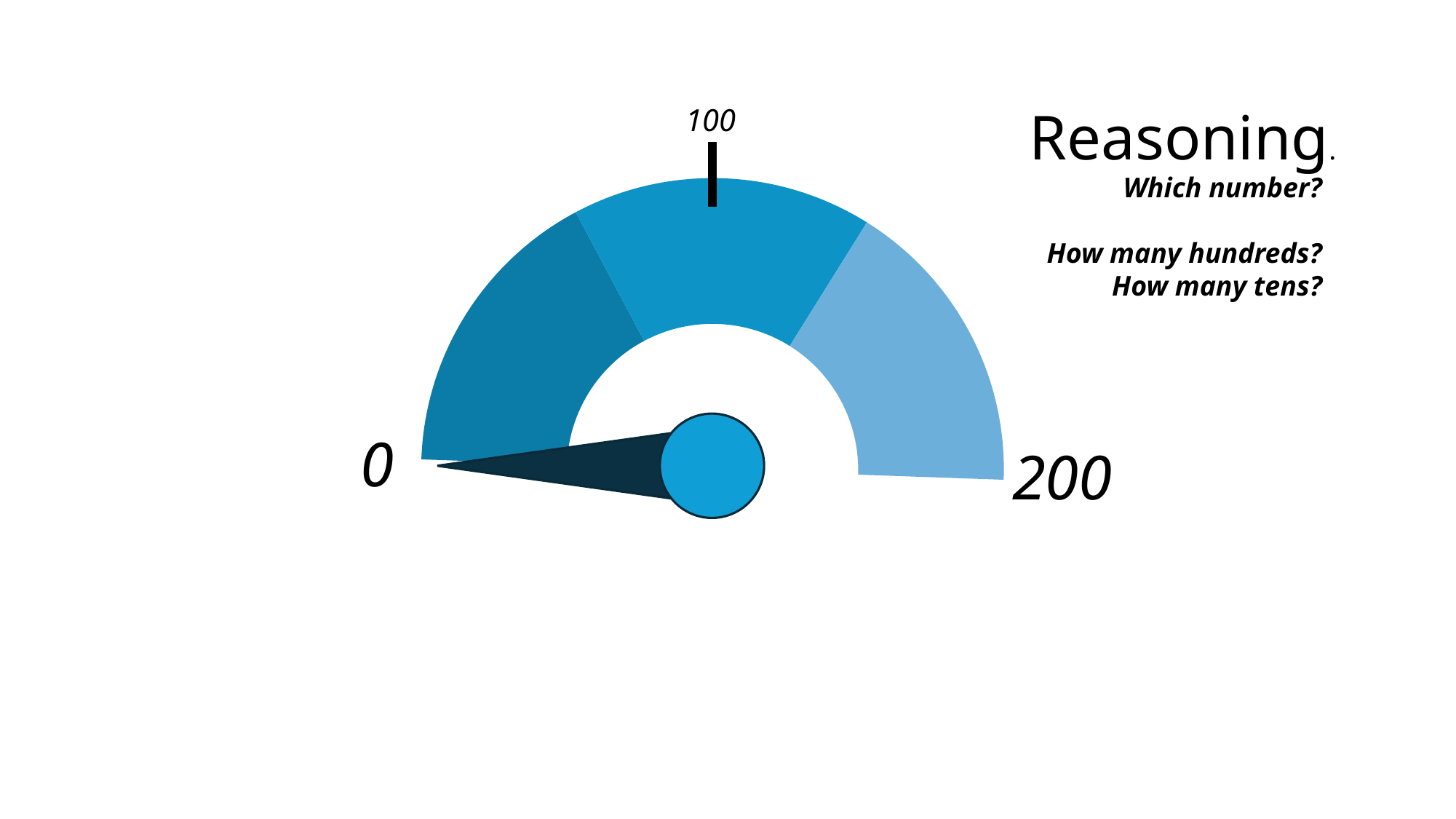
What value does the needle on the gauge point to? 0 What is the difference between the highest and lowest labelled values on the gauge? 200 What is the heading text shown to the right of the gauge? Reasoning How many numeric labels are shown on the gauge scale? 3 What is the lowest value labelled on the gauge scale? 0 What value is marked by the tick at the top of the gauge? 100 What kind of chart is shown on the slide? gauge chart Is the value indicated by the needle greater or less than 100? less Which end of the gauge is the needle pointing towards, the 0 end or the 200 end? the 0 end How many coloured segments make up the gauge arc? 3 What is the highest value labelled on the gauge scale? 200